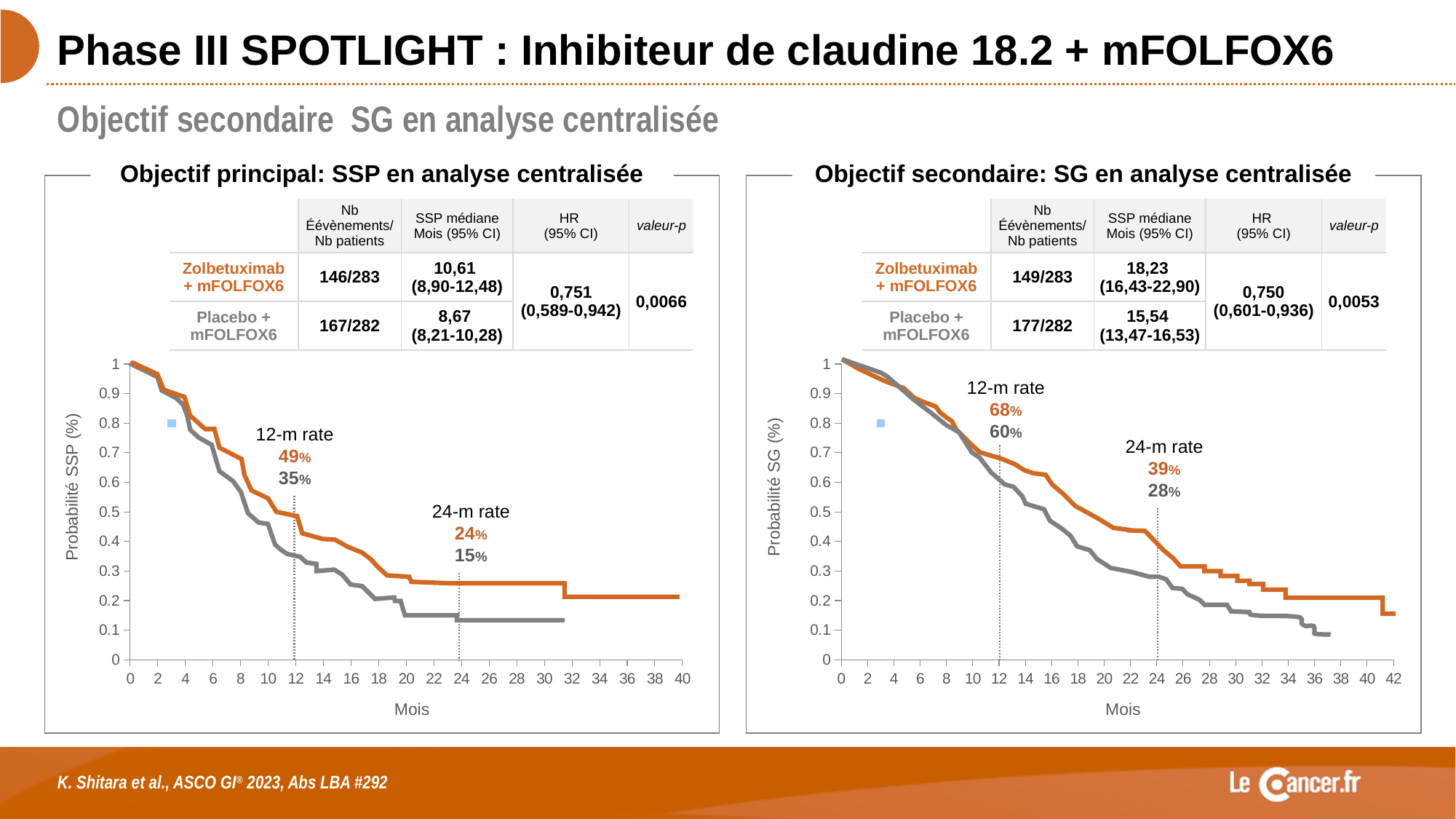
On the right chart (Objectif secondaire: SG en analyse centralisée), what is the 24-month rate shown for the orange (Zolbetuximab + mFOLFOX6) curve? 39% On the right chart (Objectif secondaire: SG en analyse centralisée), what is the 12-month rate shown for the grey (Placebo + mFOLFOX6) curve? 60% On the left chart (Objectif principal: SSP en analyse centralisée), is the value of the orange curve at 30 months greater or less than 0.2? greater On the left chart (Objectif principal: SSP en analyse centralisée), do the curves rise or fall as months increase along the x axis? Fall On the left chart (Objectif principal: SSP en analyse centralisée), what is the 12-month rate shown for the orange (Zolbetuximab + mFOLFOX6) curve? 49% On the left chart (Objectif principal: SSP en analyse centralisée), what is the difference between the 12-month rates of the orange and grey curves? 14% What kind of chart is shown on the left (Objectif principal: SSP en analyse centralisée)? Line chart (Kaplan-Meier survival curve) On the right chart (Objectif secondaire: SG en analyse centralisée), what is the difference between the 24-month rates of the orange and grey curves? 11% On the left chart (Objectif principal: SSP en analyse centralisée), what is the 24-month rate shown for the grey (Placebo + mFOLFOX6) curve? 15% What is the y-axis label of the right chart (Objectif secondaire: SG en analyse centralisée)? Probabilité SG (%) On the right chart (Objectif secondaire: SG en analyse centralisée), is the value of the grey curve at 30 months greater or less than 0.2? less On the right chart (Objectif secondaire: SG en analyse centralisée), which curve has the higher 12-month rate, orange (Zolbetuximab + mFOLFOX6) or grey (Placebo + mFOLFOX6)? Orange (Zolbetuximab + mFOLFOX6)